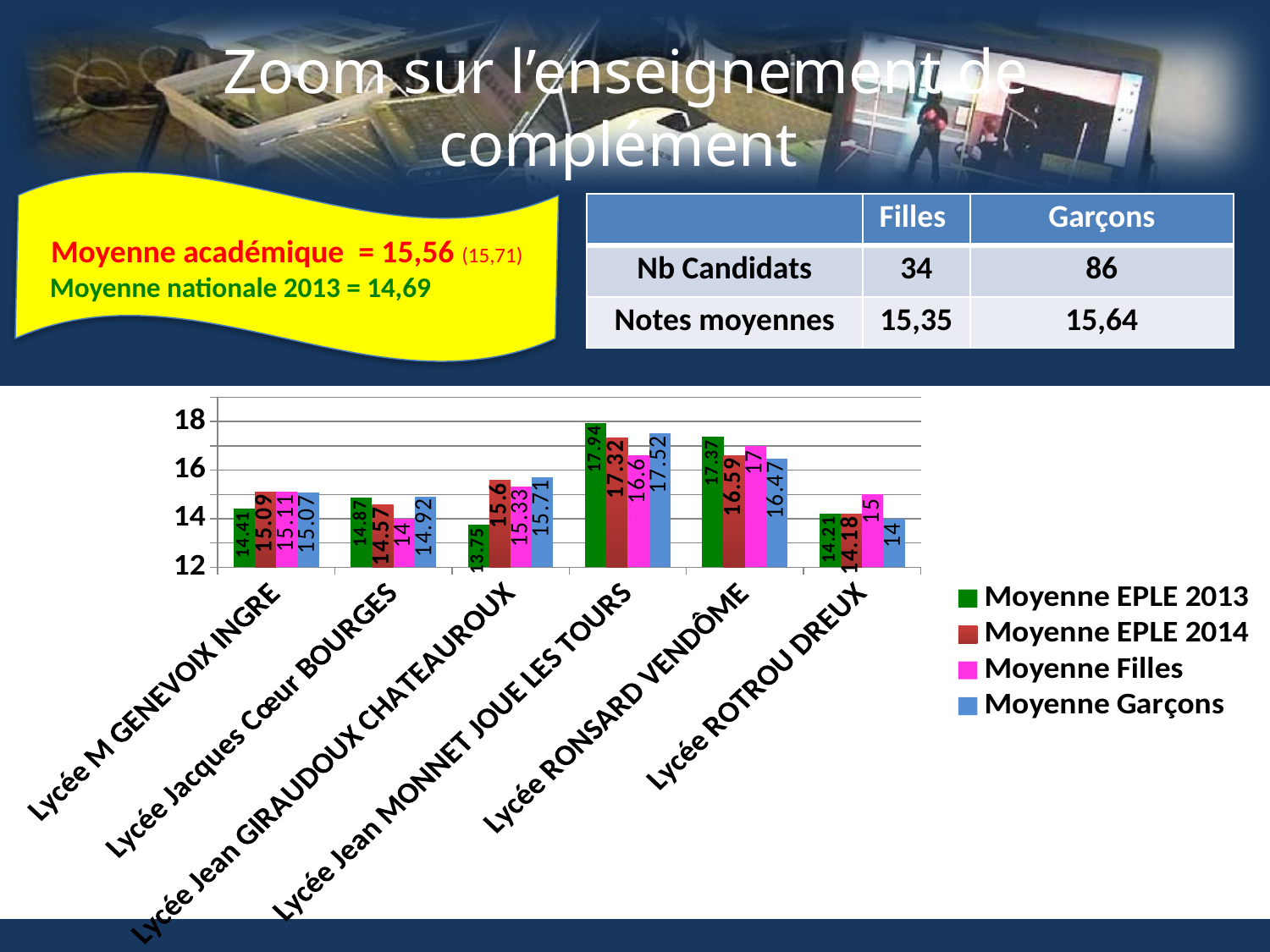
How many lycées are shown on the x axis of the chart? 6 Which lycée has the highest Moyenne EPLE 2013 value? Lycée Jean MONNET JOUE LES TOURS What is the Moyenne EPLE 2014 value for Lycée ROTROU DREUX? 14.18 Which series is shown in green in the chart legend? Moyenne EPLE 2013 What is the difference between the Moyenne EPLE 2013 and Moyenne EPLE 2014 values for Lycée Jean GIRAUDOUX CHATEAUROUX? 1.85 What is the Moyenne Filles value for Lycée RONSARD VENDÔME? 17 Which lycée has the lowest Moyenne EPLE 2013 value? Lycée Jean GIRAUDOUX CHATEAUROUX What is the Moyenne EPLE 2013 value for Lycée Jean MONNET JOUE LES TOURS? 17.94 What is the Moyenne Garçons value for Lycée Jean GIRAUDOUX CHATEAUROUX? 15.71 How many series does the chart legend list? 4 Which is larger for Lycée Jacques Cœur BOURGES: Moyenne Filles or Moyenne Garçons? Moyenne Garçons What type of chart is shown on the slide? Bar chart